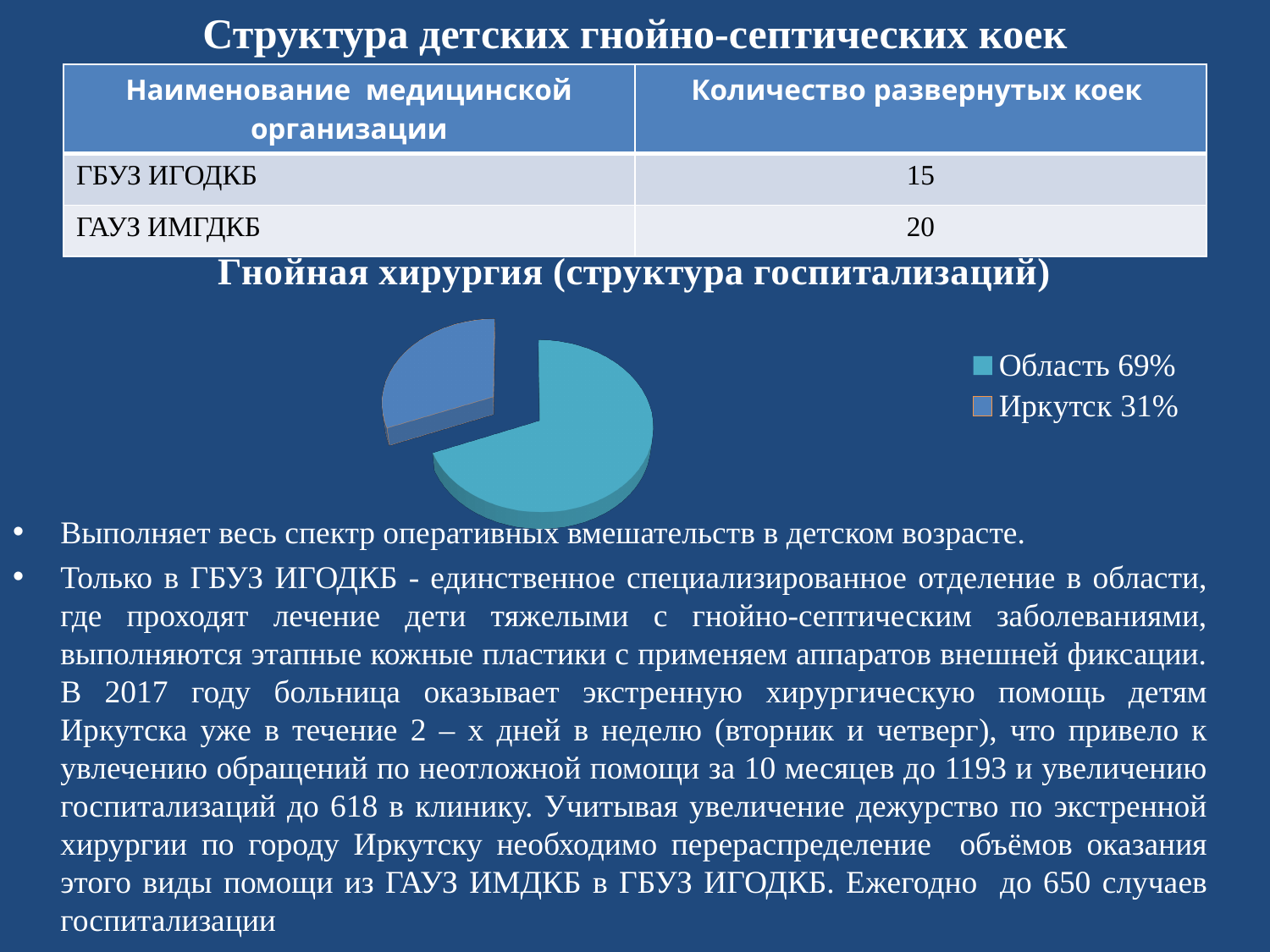
Which is larger in the pie chart, Область or Иркутск? Область How many slices does the pie chart have? 2 Which slice of the pie chart is the largest? Область Which legend entry in the pie chart is shown in the darker blue colour? Иркутск 31% What share of the pie chart does Область account for? 69% What share of the pie chart does Иркутск account for? 31% By how many percentage points does the Область share exceed the Иркутск share in the pie chart? 38 Which slice of the pie chart is the smallest? Иркутск What kind of chart is shown on the slide? Pie chart How many entries does the pie chart's legend list? 2 What is the title of the chart on the slide? Гнойная хирургия (структура госпитализаций)